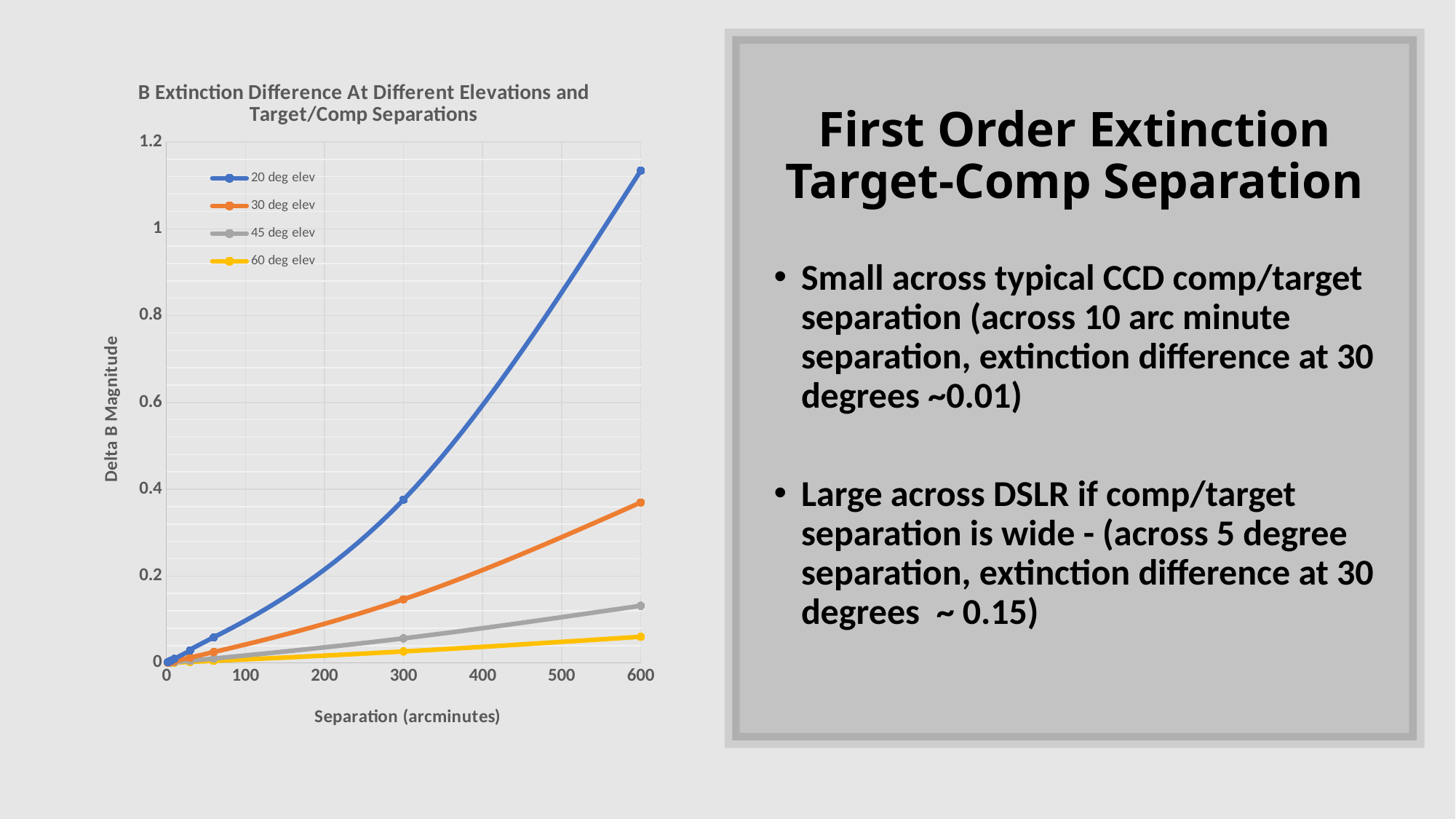
At 600 arcminutes, which is larger: the value for 30 deg elev or the value for 45 deg elev? 30 deg elev Is the value for 30 deg elev at 600 arcminutes greater or less than 0.4? less Is the value for 20 deg elev at 300 arcminutes greater or less than 0.2? greater What kind of chart is shown on the slide? line chart Which series has the highest Delta B Magnitude at a separation of 600 arcminutes? 20 deg elev Which series has the lowest Delta B Magnitude at a separation of 600 arcminutes? 60 deg elev What is the label of the chart's y axis? Delta B Magnitude What is the title of the chart? B Extinction Difference At Different Elevations and Target/Comp Separations Is the value for 20 deg elev at 600 arcminutes greater or less than 1? greater Does the Delta B Magnitude for 20 deg elev rise or fall as separation increases? rise How many series does the chart's legend list? 4